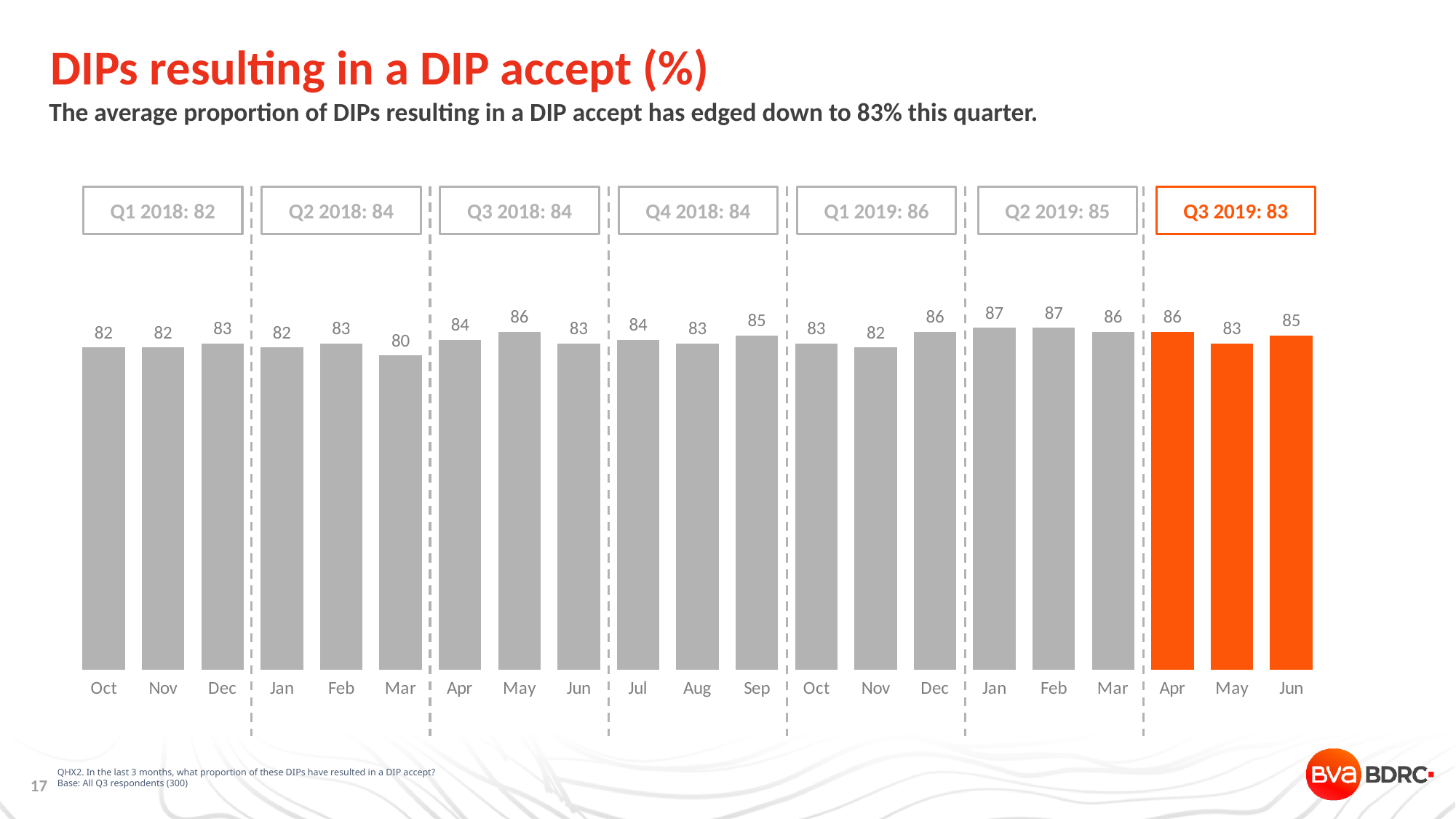
What is the value for Dec in Q1 2019? 86 Which month has the lowest value in the chart? Mar (Q2 2018) What is the quarterly average shown for Q1 2019? 86 What is the value for Mar in Q2 2018? 80 Which quarter's bars are highlighted in orange? Q3 2019 What is the highest monthly value shown in the chart? 87 How many monthly bars are plotted in the chart? 21 Which is larger, the value for May in Q3 2018 or the value for Jun in Q3 2018? May in Q3 2018 What is the quarterly average shown for Q3 2019? 83 What is the difference between the value for Jan in Q2 2019 and the value for Mar in Q2 2018? 7 What is the value for May in Q3 2019? 83 What kind of chart is shown on the slide? Bar chart